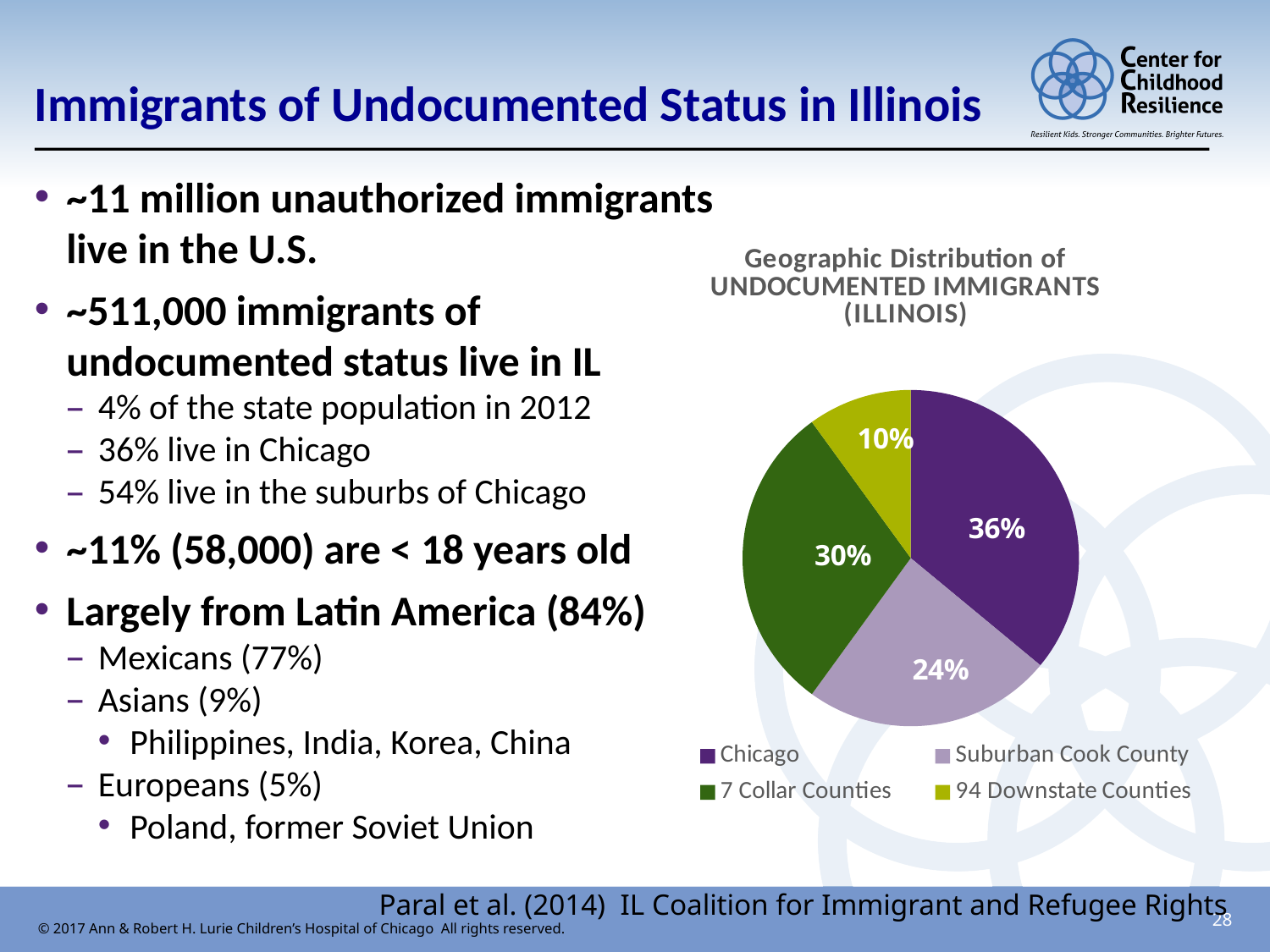
What is the title of the chart? Geographic Distribution of UNDOCUMENTED IMMIGRANTS (ILLINOIS) Which category has the largest slice of the pie? Chicago What colour is the Chicago slice in the pie chart? Purple What share of the pie does Suburban Cook County represent? 24% What share of the pie do the 7 Collar Counties represent? 30% Which category has the smallest slice of the pie? 94 Downstate Counties What is the difference in percentage points between the Chicago slice and the Suburban Cook County slice? 12 How many categories are shown in the pie chart? 4 Which is larger, the 7 Collar Counties slice or the Suburban Cook County slice? 7 Collar Counties What share of the pie do the 94 Downstate Counties represent? 10% What kind of chart is shown on the slide? Pie chart What share of the pie does Chicago represent? 36%